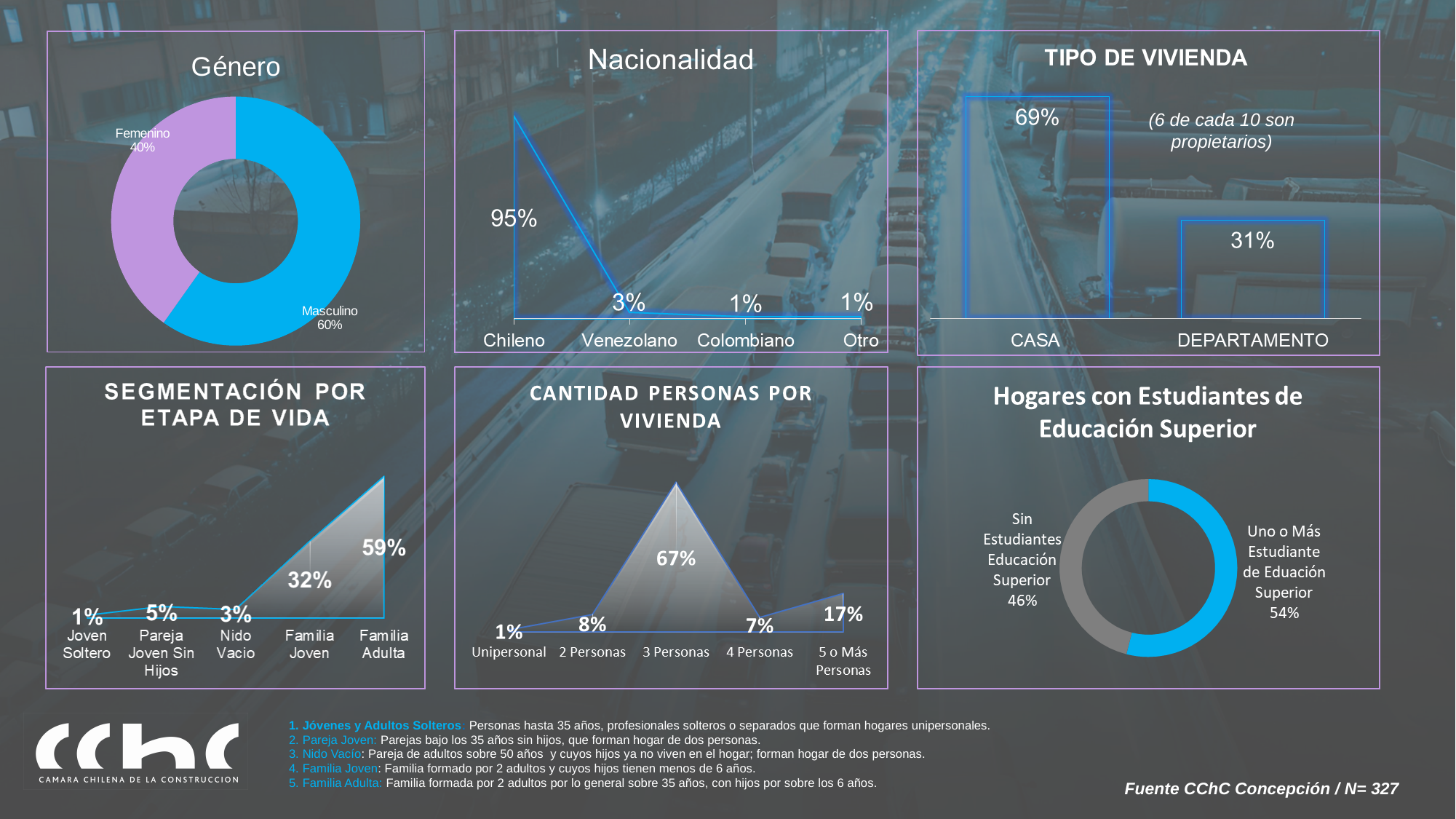
In the 'Hogares con Estudiantes de Educación Superior' chart, what share of households have Uno o Más Estudiante de Eduación Superior? 54% In the 'Segmentación por Etapa de Vida' chart, which is larger: Pareja Joven Sin Hijos or Nido Vacio? Pareja Joven Sin Hijos In the 'Segmentación por Etapa de Vida' chart, which category has the highest value? Familia Adulta What kind of chart is the 'Tipo de Vivienda' chart? Bar chart In the 'Nacionalidad' chart, how many nationality categories are shown on the x axis? 4 In the 'Cantidad Personas por Vivienda' chart, what is the value for 5 o Más Personas? 17% In the 'Tipo de Vivienda' chart, what is the difference between CASA and DEPARTAMENTO? 38% In the 'Nacionalidad' chart, what is the value for Chileno? 95% What kind of chart is the 'Género' chart? Donut (pie) chart In the 'Género' chart, what percentage is Masculino? 60% In the 'Segmentación por Etapa de Vida' chart, what is the value for Familia Joven? 32% In the 'Cantidad Personas por Vivienda' chart, which category has the lowest value? Unipersonal